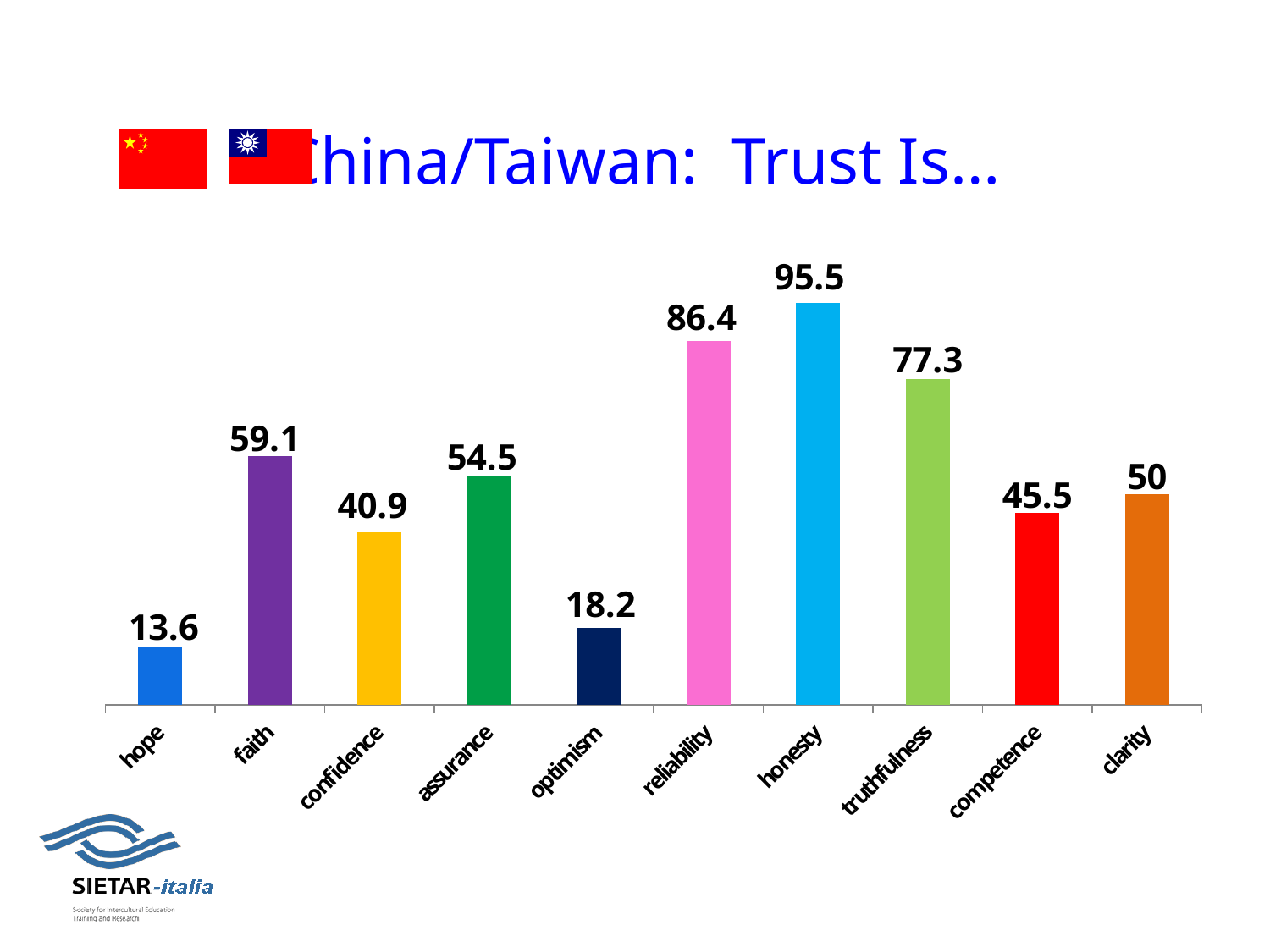
What is the difference between the values for faith and confidence? 18.2 What is the value for clarity? 50 What is the value for hope? 13.6 What is the value for truthfulness? 77.3 How many categories are shown on the x axis? 10 Which category has the lowest value? hope What is the difference between the values for honesty and reliability? 9.1 Which is larger, the value for assurance or the value for competence? assurance What is the value for honesty? 95.5 What kind of chart is shown on the slide? bar chart What is the title of the slide? China/Taiwan: Trust Is... Which category has the highest value? honesty